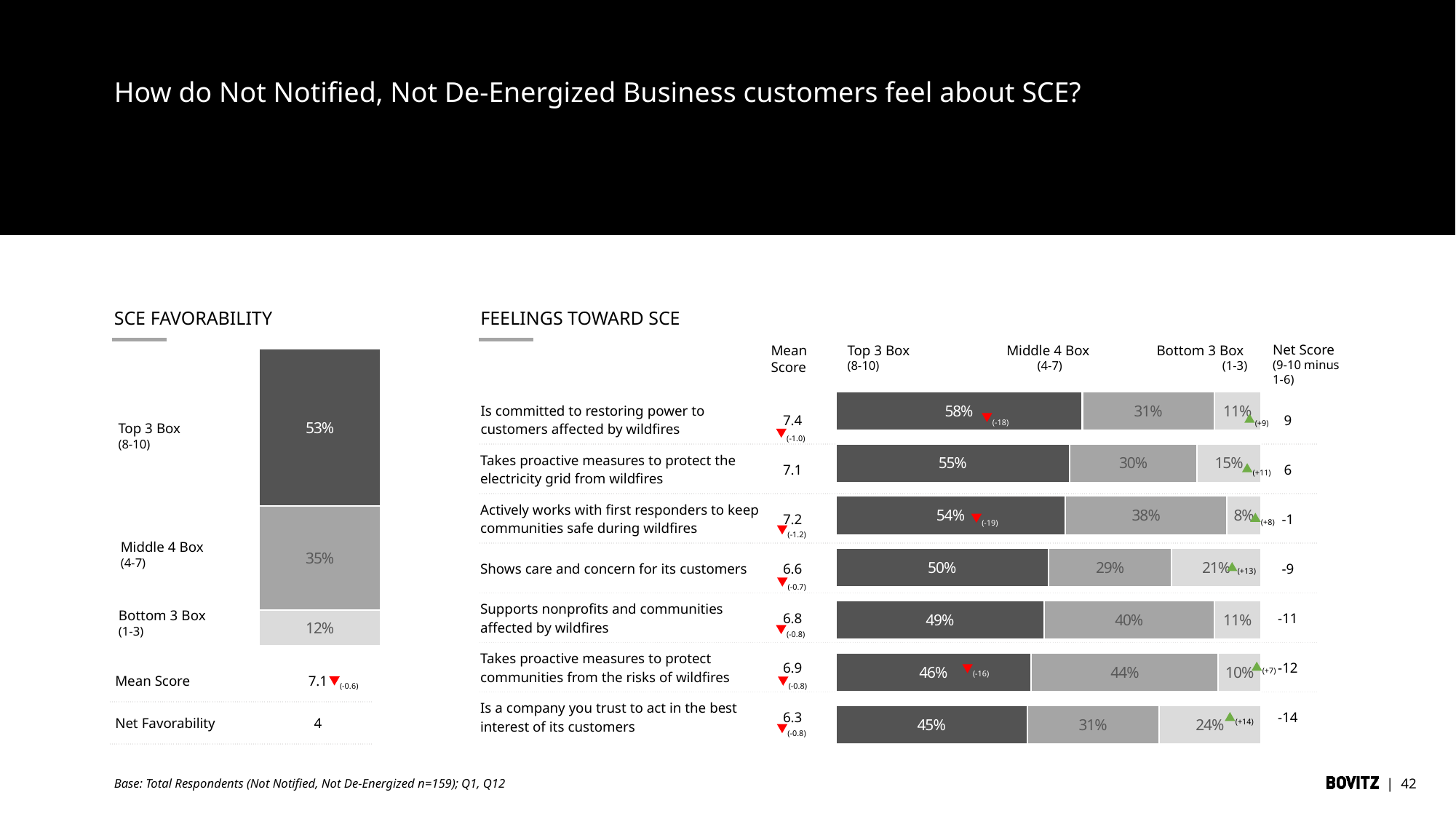
In the FEELINGS TOWARD SCE chart, which statement has the lowest Mean Score? Is a company you trust to act in the best interest of its customers In the SCE FAVORABILITY chart, what percentage is shown for Bottom 3 Box (1-3)? 12% In the SCE FAVORABILITY chart, what percentage is shown for Top 3 Box (8-10)? 53% In the FEELINGS TOWARD SCE chart, which is larger: the Bottom 3 Box percentage for 'Shows care and concern for its customers' or for 'Supports nonprofits and communities affected by wildfires'? Shows care and concern for its customers In the FEELINGS TOWARD SCE chart, what is the Bottom 3 Box percentage for 'Is a company you trust to act in the best interest of its customers'? 24% In the FEELINGS TOWARD SCE chart, what is the Middle 4 Box percentage for 'Takes proactive measures to protect communities from the risks of wildfires'? 44% In the FEELINGS TOWARD SCE chart, what is the Top 3 Box percentage for 'Is committed to restoring power to customers affected by wildfires'? 58% In the SCE FAVORABILITY chart, which box segment is the smallest? Bottom 3 Box (1-3) In the SCE FAVORABILITY chart, what is the difference between the Top 3 Box and Middle 4 Box percentages? 18% In the FEELINGS TOWARD SCE chart, what is the Net Score for 'Shows care and concern for its customers'? -9 In the FEELINGS TOWARD SCE chart, which statement has the highest Top 3 Box percentage? Is committed to restoring power to customers affected by wildfires In the FEELINGS TOWARD SCE chart, how many statements are plotted? 7